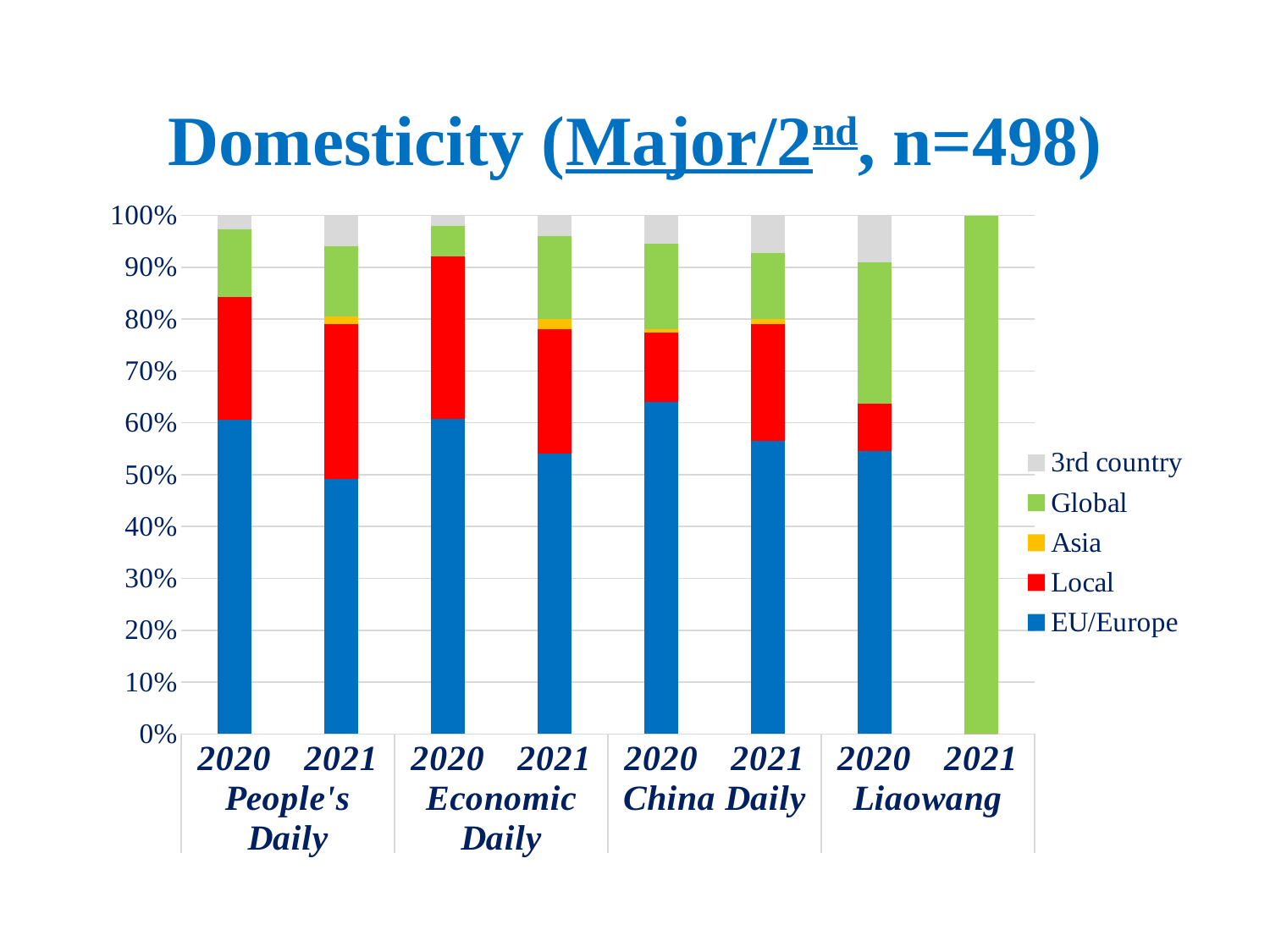
Is the EU/Europe value for People's Daily 2020 greater or less than 50%? greater What is the title of the chart? Domesticity (Major/2nd, n=498) Is the Local segment larger for Economic Daily 2020 or for People's Daily 2020? Economic Daily 2020 How many bars are plotted in the chart? 8 Does the EU/Europe share for People's Daily rise or fall from 2020 to 2021? fall Is the Global segment larger for Liaowang 2020 or for Economic Daily 2020? Liaowang 2020 Which series is shown in red in the legend? Local How many series does the legend list? 5 What kind of chart is shown on the slide? Stacked bar chart Is the EU/Europe value for Liaowang 2020 greater or less than 60%? less Which bar has the largest EU/Europe segment? China Daily 2020 Is the EU/Europe value for China Daily 2020 greater or less than 60%? greater